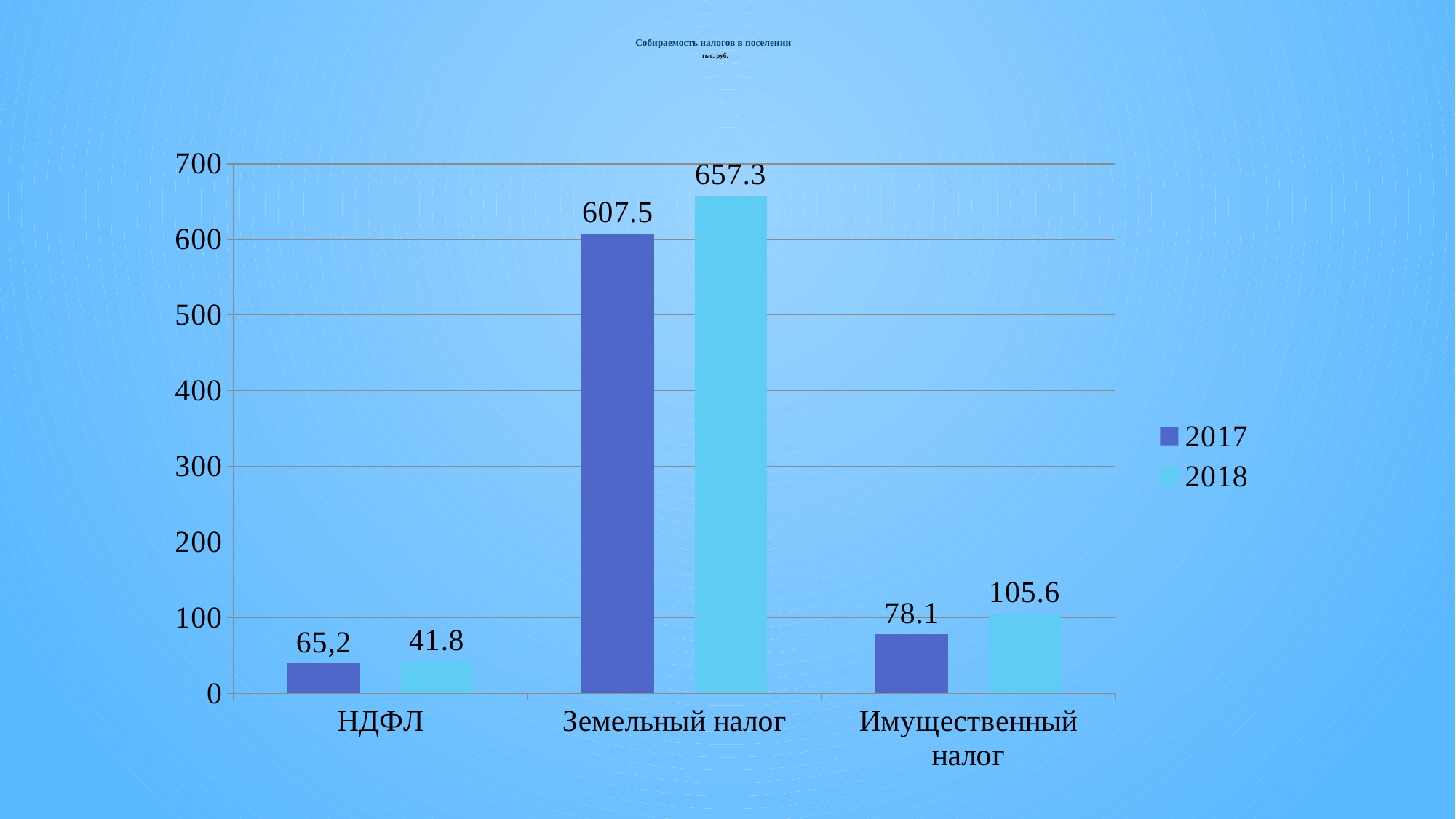
What is the difference between the 2018 and 2017 values for Имущественный налог? 27.5 How many series does the legend list? 2 How many categories are shown on the x axis? 3 What is the value for Имущественный налог in 2017? 78.1 Which category has the highest value in 2017? Земельный налог What is the value for Имущественный налог in 2018? 105.6 What is the difference between the 2018 and 2017 values for Земельный налог? 49.8 What kind of chart is shown on the slide? Bar chart Which category has the lowest value in 2018? НДФЛ What is the value for Земельный налог in 2018? 657.3 What is the value for НДФЛ in 2017? 65,2